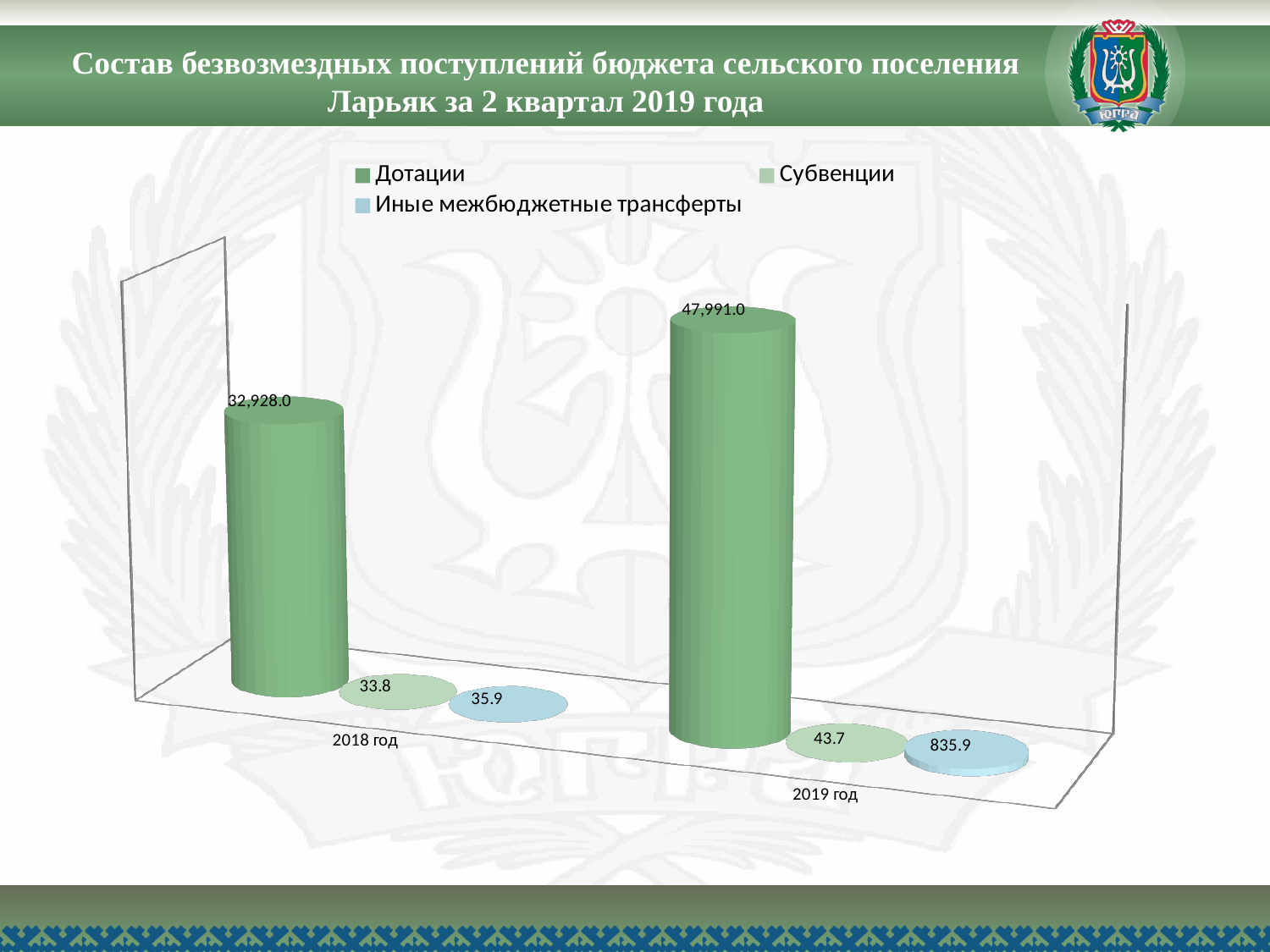
What kind of chart is shown on the slide? Bar chart What is the value of Субвенции for 2019 год? 43.7 What is the value of Дотации for 2018 год? 32,928.0 What is the value of Иные межбюджетные трансферты for 2018 год? 35.9 Which series has the highest value in 2019 год? Дотации What is the value of Иные межбюджетные трансферты for 2019 год? 835.9 Which series has the lowest value in 2018 год? Субвенции How many series does the legend list? 3 Which is larger: Иные межбюджетные трансферты in 2018 год or in 2019 год? 2019 год What is the value of Дотации for 2019 год? 47,991.0 What is the difference between the Дотации values for 2019 год and 2018 год? 15,063.0 How many categories are shown on the x axis? 2